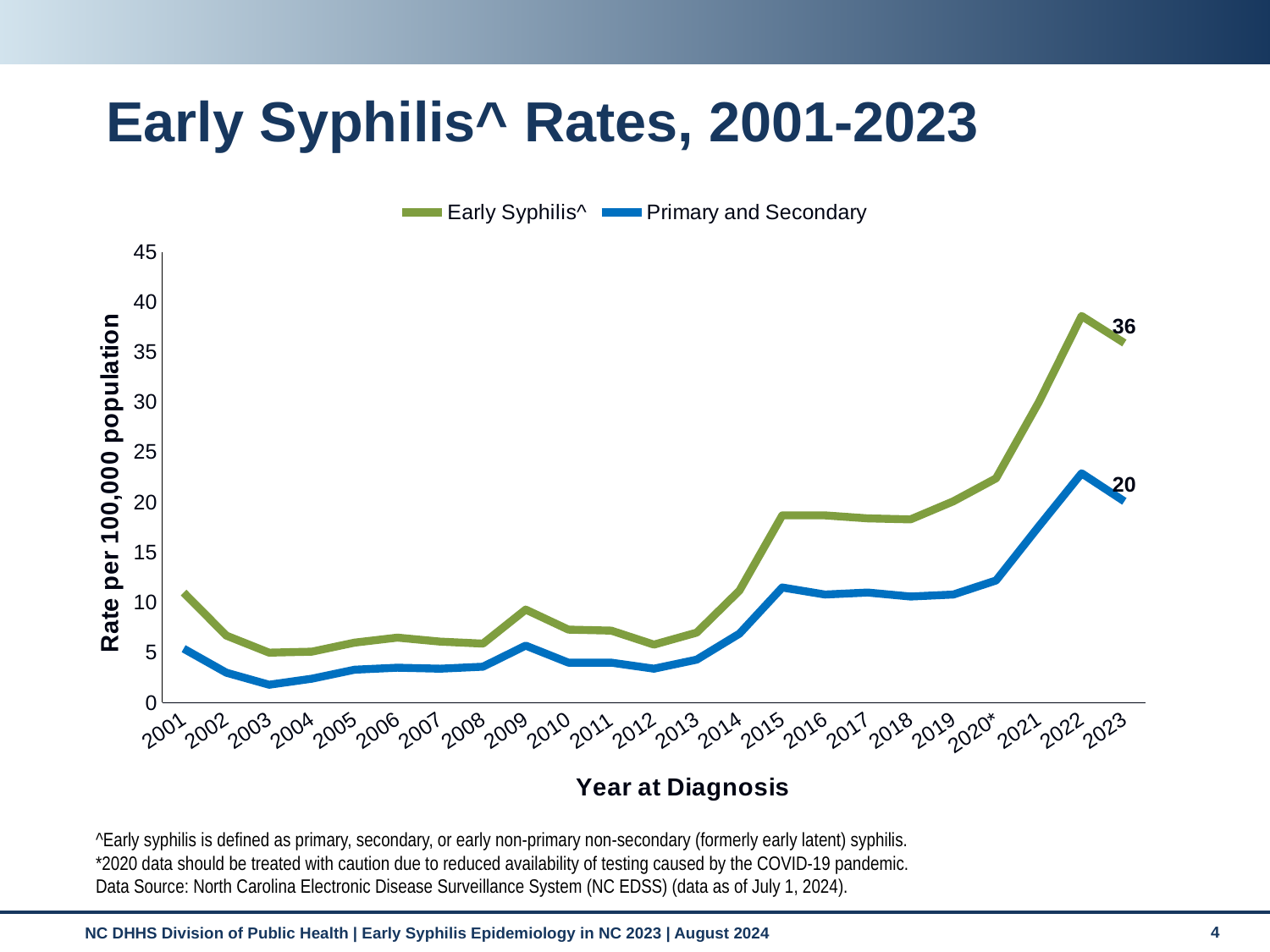
What kind of chart is shown on the slide? Line chart How many years are plotted along the x axis? 23 Is the Primary and Secondary rate in 2012 greater or less than 5? less What is the title of the y axis? Rate per 100,000 population Which series has the higher value in 2023, Early Syphilis^ or Primary and Secondary? Early Syphilis^ What is the Early Syphilis^ rate in 2023? 36 In which year does the Early Syphilis^ rate reach its highest point? 2022 Is the Early Syphilis^ rate in 2015 greater or less than 15? greater What is the difference between the Early Syphilis^ rate and the Primary and Secondary rate in 2023? 16 What is the Primary and Secondary rate in 2023? 20 How many series does the legend list? 2 In which year does the Primary and Secondary rate reach its highest point? 2022